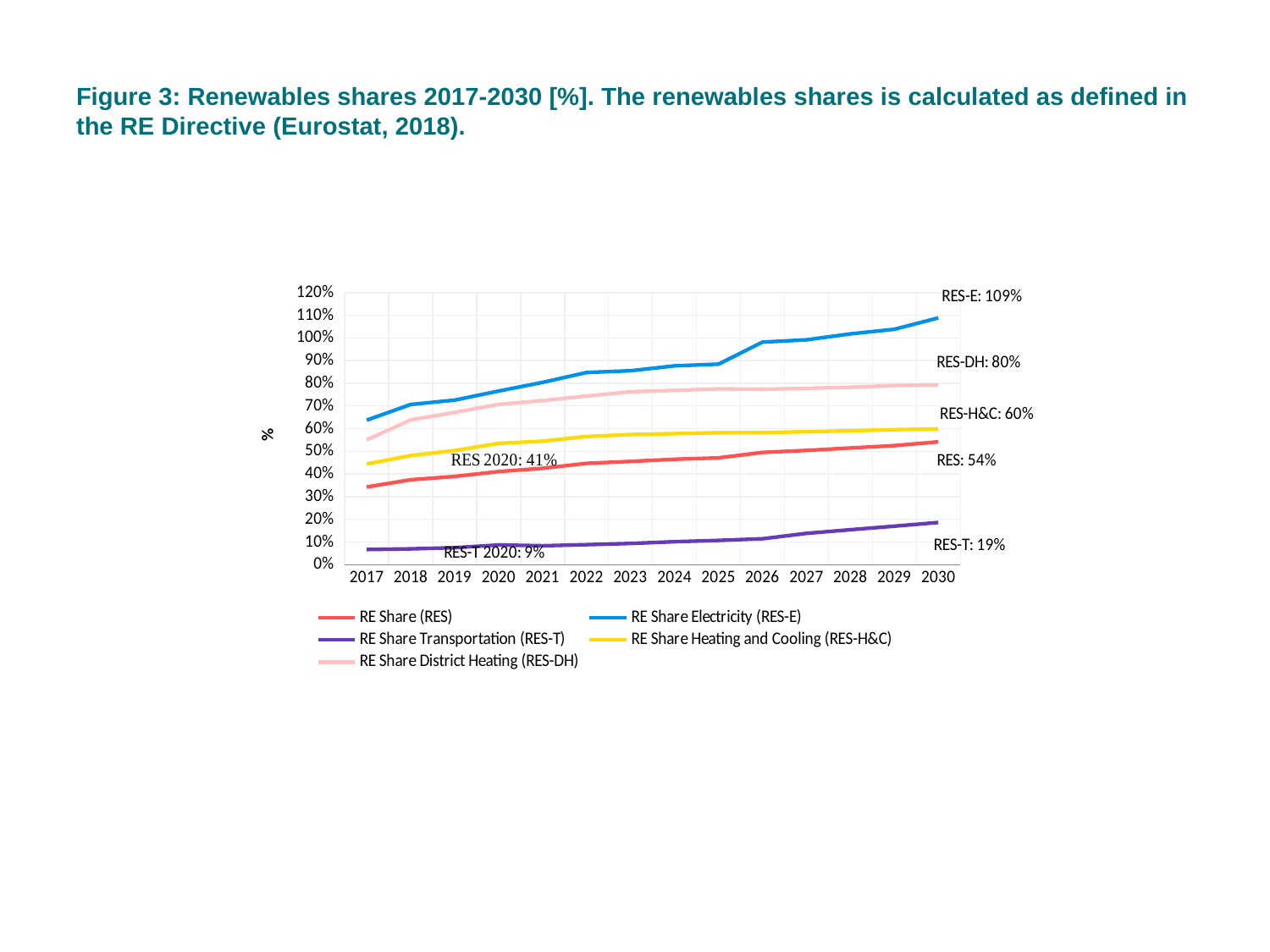
What is the RE Share Transportation (RES-T) value in 2020? 9% What is the RE Share (RES) value in 2020? 41% What type of chart is shown on the slide? line chart How many series does the legend list? 5 What is the RE Share District Heating (RES-DH) value in 2030? 80% How many years are shown on the x axis? 14 Does the RE Share Transportation (RES-T) line rise or fall from 2017 to 2030? rise Is the RE Share Electricity (RES-E) value in 2017 greater or less than 60%? greater Which series has the lowest value in 2030? RE Share Transportation (RES-T) Which series has the highest value in 2030? RE Share Electricity (RES-E) What is the RE Share Electricity (RES-E) value in 2030? 109% What is the difference between the RES-E and RES-DH values in 2030? 29%